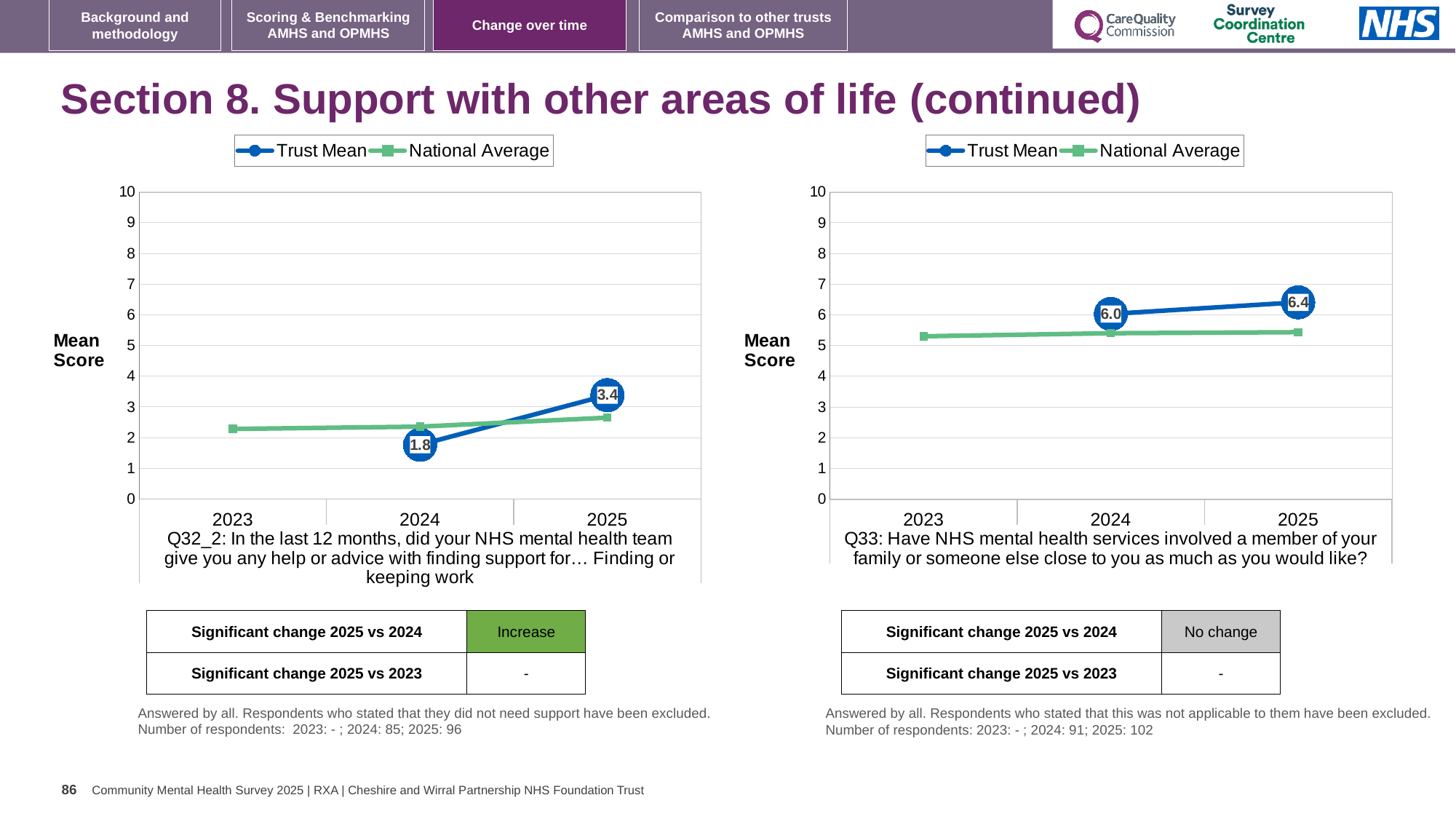
In the left chart (Q32_2), does the Trust Mean rise or fall from 2024 to 2025? rise In the right chart (Q33), what is the Trust Mean for 2025? 6.4 In the right chart (Q33), what is the Trust Mean for 2024? 6.0 In the right chart (Q33), is the National Average for 2025 greater or less than 6? less In the left chart (Q32_2), what is the Trust Mean for 2024? 1.8 In the left chart (Q32_2), what is the Trust Mean for 2025? 3.4 In the left chart (Q32_2), by how much did the Trust Mean change from 2024 to 2025? 1.6 What type of chart is used for Q33 on the right of the slide? Line chart How many years are shown on the x axis of the left chart (Q32_2)? 3 How many series does the legend of the right chart (Q33) list? 2 In the right chart (Q33), what is the difference between the Trust Mean in 2025 and in 2024? 0.4 In the left chart (Q32_2), which is larger in 2025: the Trust Mean or the National Average? Trust Mean